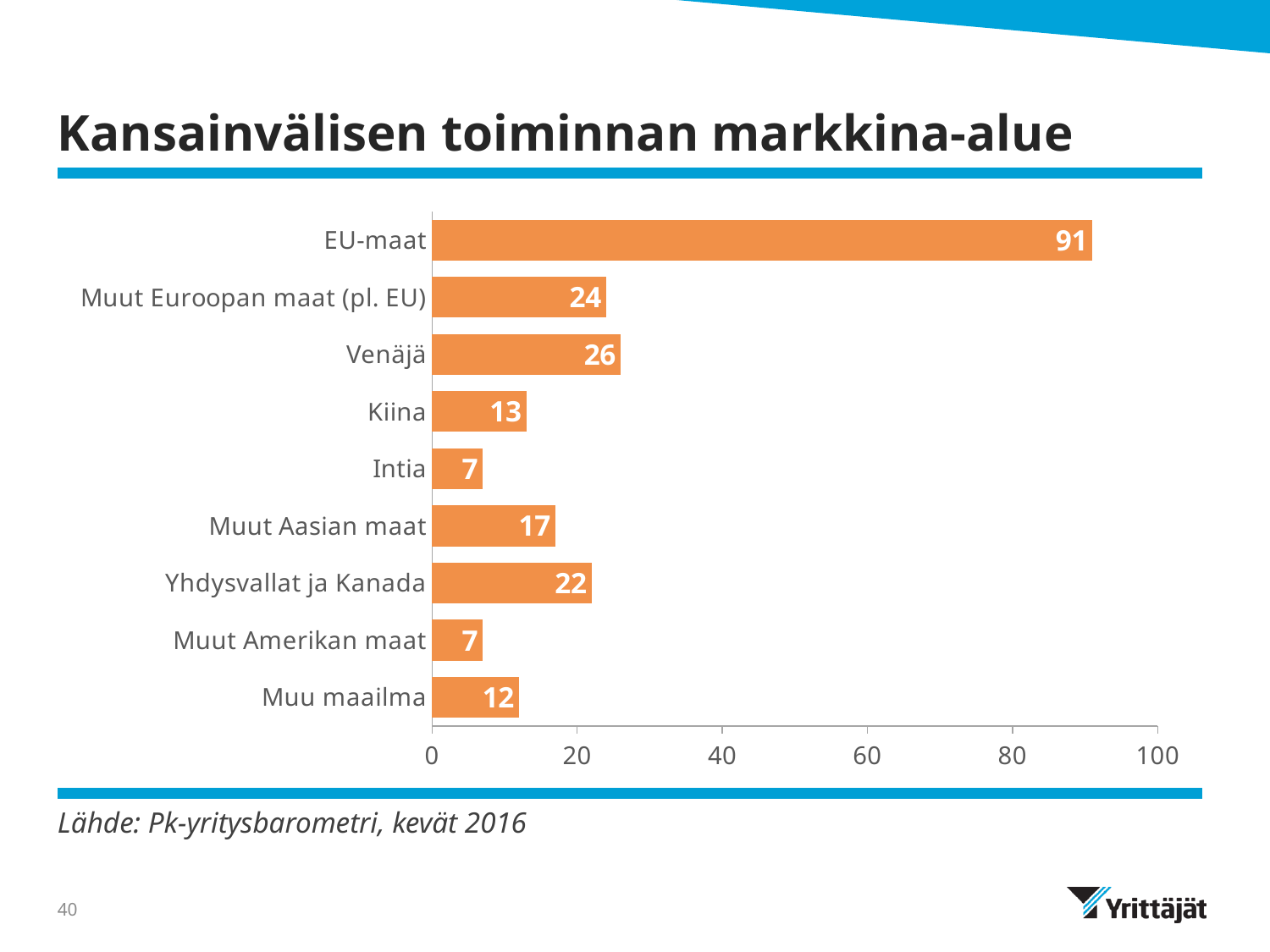
Which category has the highest value? EU-maat Is the value for Muut Aasian maat greater or less than 20? less What is the value for Muu maailma? 12 What kind of chart is shown on the slide? bar chart How many categories are shown in the chart? 9 What is the difference between the values for Muut Euroopan maat (pl. EU) and Kiina? 11 What is the title of the slide? Kansainvälisen toiminnan markkina-alue What is the value for Venäjä? 26 What is the difference between the values for EU-maat and Venäjä? 65 What is the value for Yhdysvallat ja Kanada? 22 Which is larger, the value for Venäjä or the value for Muut Euroopan maat (pl. EU)? Venäjä What is the value for EU-maat? 91